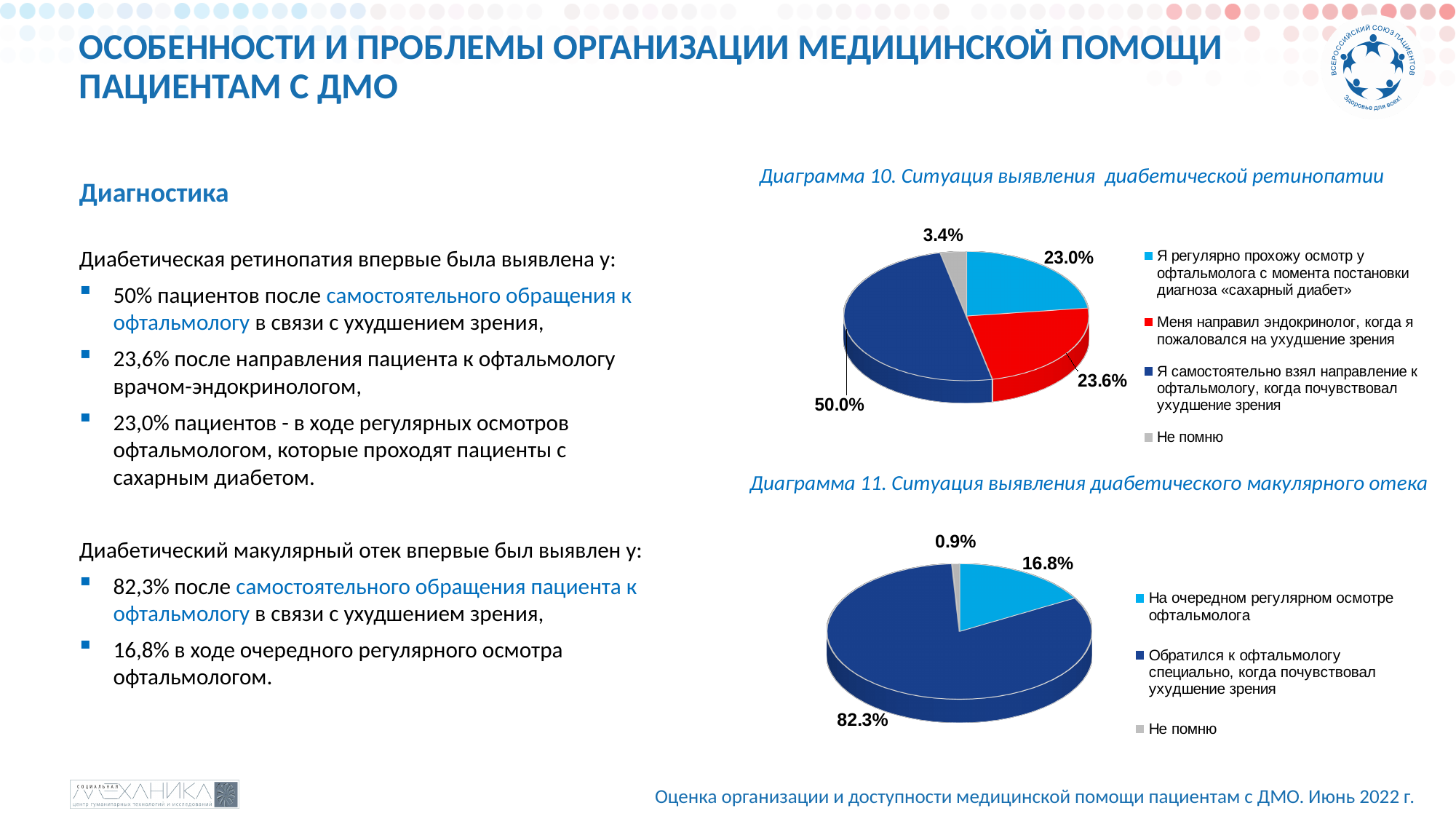
In Diagram 11, what is the share of «Не помню»? 0.9% In Diagram 10, what is the difference between the 50.0% slice and the 23.0% slice? 27.0% In Diagram 10 (Ситуация выявления диабетической ретинопатии), what share of respondents chose «Я самостоятельно взял направление к офтальмологу, когда почувствовал ухудшение зрения»? 50.0% In Diagram 10, which category has the largest slice? Я самостоятельно взял направление к офтальмологу, когда почувствовал ухудшение зрения In Diagram 10, what is the share of the «Не помню» slice? 3.4% In Diagram 10, how many categories does the legend list? 4 In Diagram 11, what percentage is shown for «На очередном регулярном осмотре офтальмолога»? 16.8% In Diagram 10, what percentage corresponds to «Меня направил эндокринолог, когда я пожаловался на ухудшение зрения»? 23.6% In Diagram 10, which category has the smallest slice? Не помню In Diagram 11, which is larger: the share for «На очередном регулярном осмотре офтальмолога» or for «Обратился к офтальмологу специально, когда почувствовал ухудшение зрения»? Обратился к офтальмологу специально, когда почувствовал ухудшение зрения What type of chart is used for Diagram 11? Pie chart In Diagram 11 (Ситуация выявления диабетического макулярного отека), what share corresponds to «Обратился к офтальмологу специально, когда почувствовал ухудшение зрения»? 82.3%